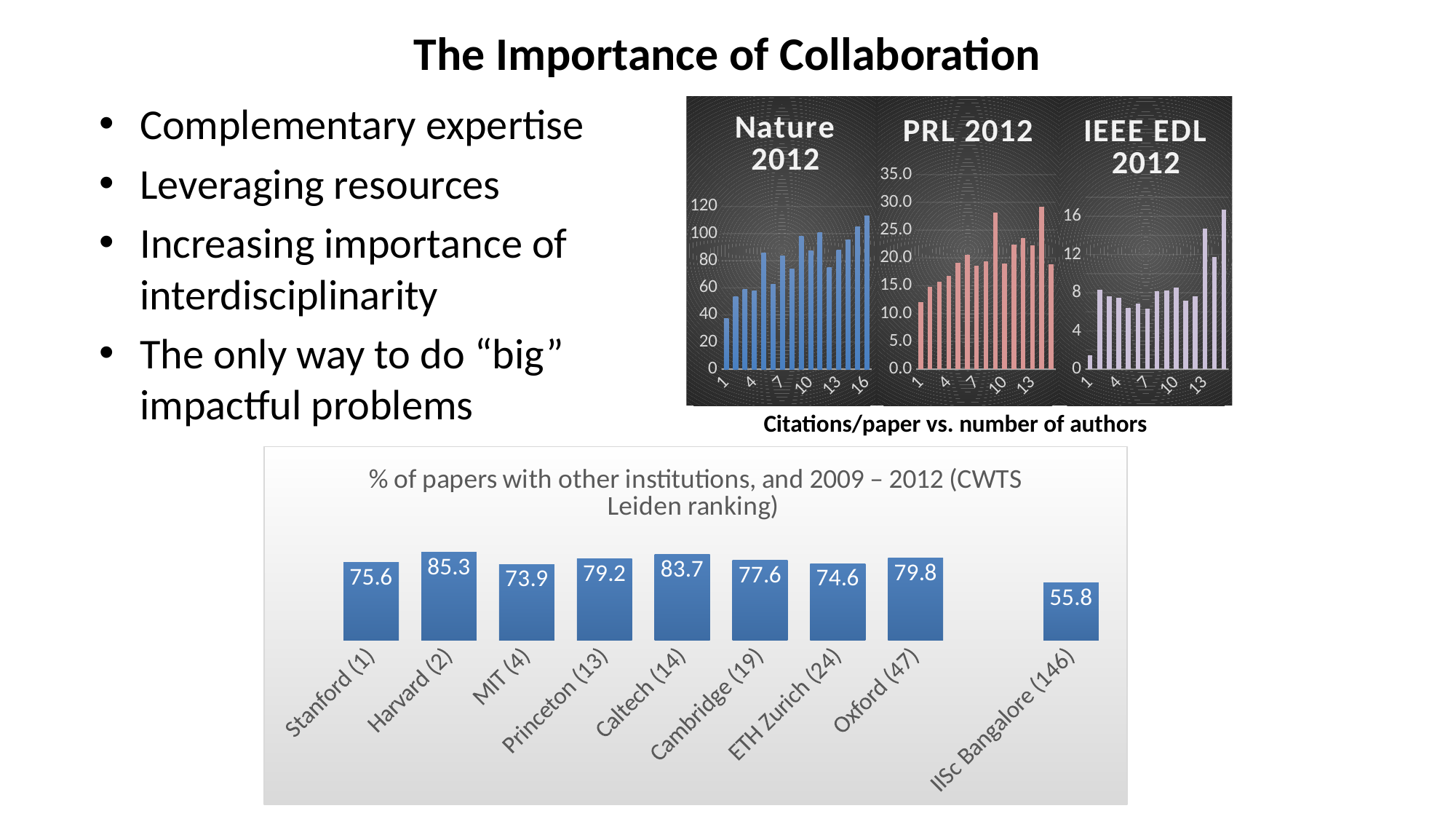
In the bottom chart (% of papers with other institutions), what is the value for IISc Bangalore (146)? 55.8 In the bottom chart (% of papers with other institutions), what is the value for Caltech (14)? 83.7 What kind of chart is the bottom chart (% of papers with other institutions)? Bar chart How many institutions are shown in the bottom chart (% of papers with other institutions)? 9 In the IEEE EDL 2012 chart, is the value for 1 author greater or less than 4? less In the bottom chart (% of papers with other institutions), what is the value for Harvard (2)? 85.3 In the Nature 2012 chart, do citations per paper generally rise or fall as the number of authors increases? Rise In the bottom chart (% of papers with other institutions), which is larger, the value for Princeton (13) or the value for Oxford (47)? Oxford (47) In the Nature 2012 chart, is the value for 16 authors greater or less than 100? greater In the bottom chart (% of papers with other institutions), which institution has the highest value? Harvard (2) In the bottom chart (% of papers with other institutions), which institution has the lowest value? IISc Bangalore (146) In the bottom chart (% of papers with other institutions), what is the difference between the values for Harvard (2) and MIT (4)? 11.4